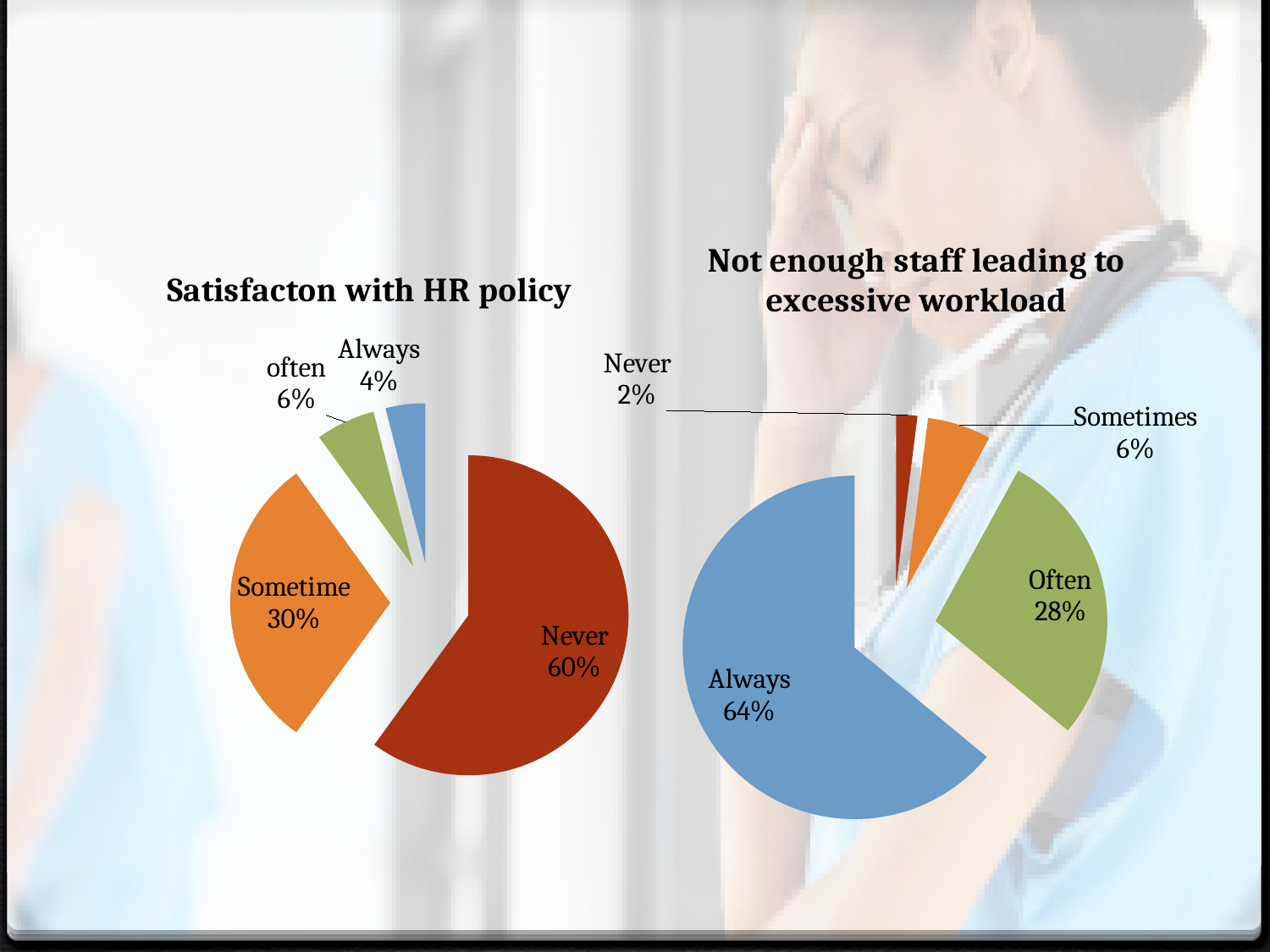
In the 'Not enough staff leading to excessive workload' chart, what percentage is shown for Always? 64% In the 'Satisfacton with HR policy' chart, what percentage is shown for Never? 60% In the 'Not enough staff leading to excessive workload' chart, which category has the largest share? Always What kind of chart is used on the left side of the slide? Pie chart In the 'Not enough staff leading to excessive workload' chart, which category has the smallest share? Never In the 'Satisfacton with HR policy' chart, what percentage is shown for Sometime? 30% In the 'Not enough staff leading to excessive workload' chart, what percentage is shown for Often? 28% In the 'Satisfacton with HR policy' chart, how many slices does the pie have? 4 In the 'Satisfacton with HR policy' chart, which category has the smallest slice? Always What is the title of the chart on the right side of the slide? Not enough staff leading to excessive workload In the 'Satisfacton with HR policy' chart, what is the difference between the Never and Sometime percentages? 30% In the 'Not enough staff leading to excessive workload' chart, which is larger, Sometimes or Often? Often